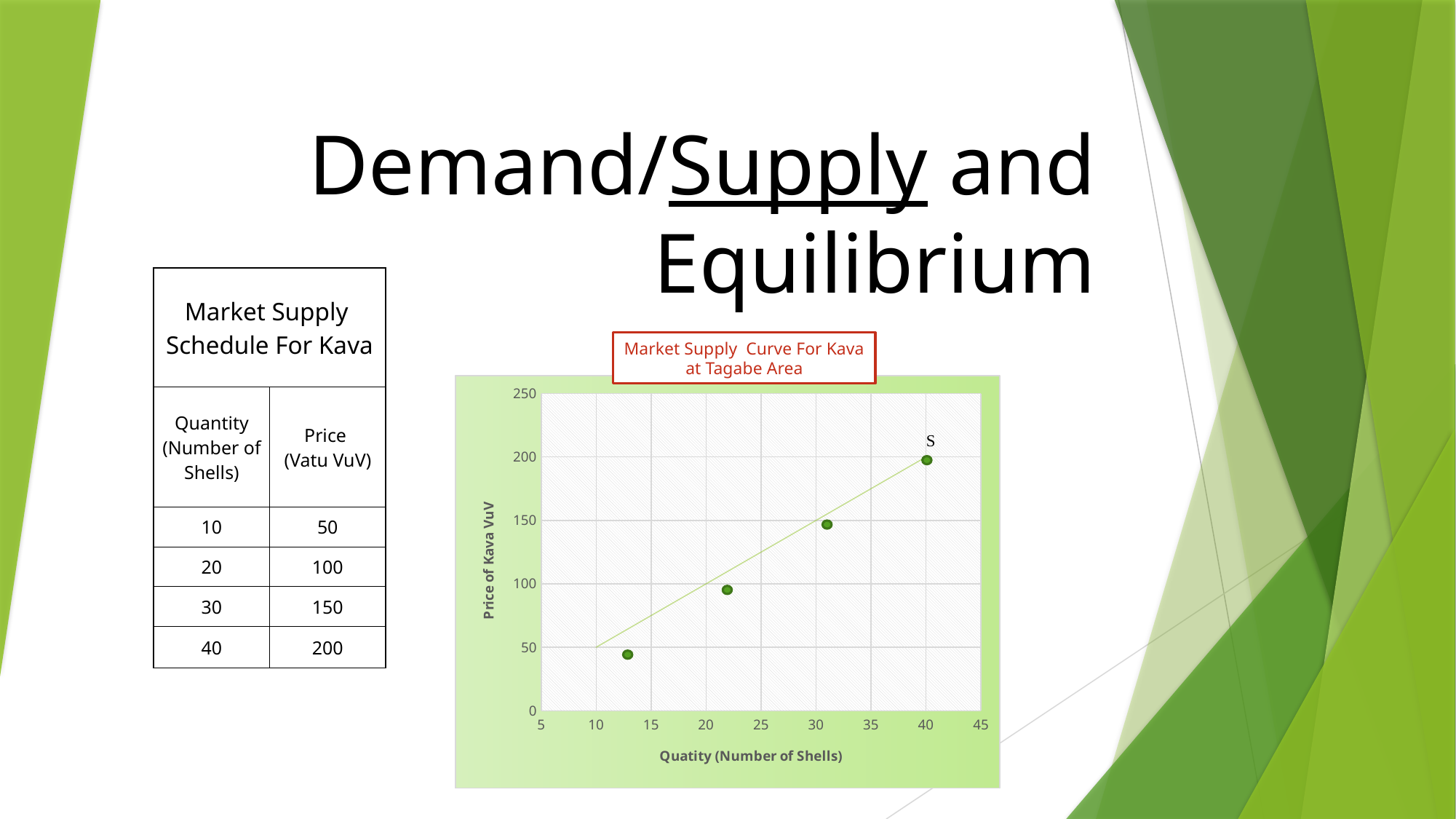
Is the price for the leftmost point (near quantity 13) greater or less than 100? less Which plotted point has the highest price? the rightmost point (near quantity 40) Is the price for the rightmost point (near quantity 40) greater or less than 150? greater What kind of chart is shown on the slide? scatter chart Is the price for the point near quantity 22 greater or less than 50? greater Which plotted point has the lowest price? the leftmost point (near quantity 13) How many data points are plotted on the chart? 4 Which has the larger price: the point near quantity 31 or the point near quantity 22? the point near quantity 31 What is the title of the chart? Market Supply Curve For Kava at Tagabe Area Do the plotted prices rise or fall as quantity increases along the x axis? rise